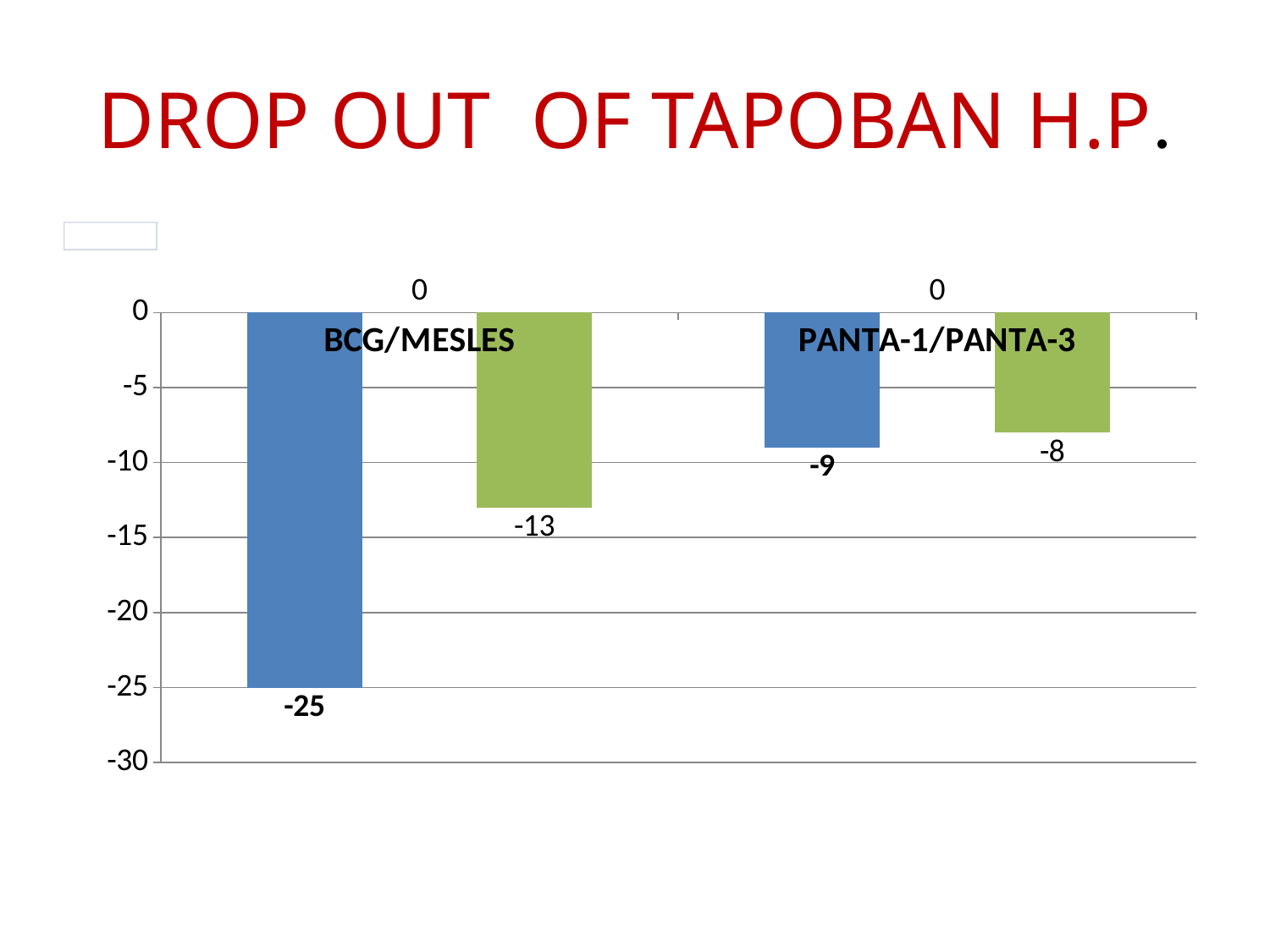
What kind of chart is shown on the slide? bar chart What is the difference between the green bar values for BCG/MESLES and PANTA-1/PANTA-3? 5 What is the difference between the blue bar values for BCG/MESLES and PANTA-1/PANTA-3? 16 What is the title of the slide containing the chart? DROP OUT OF TAPOBAN H.P. What is the value of the blue bar for BCG/MESLES? -25 What is the value of the green bar for BCG/MESLES? -13 Which category has the longer blue bar, BCG/MESLES or PANTA-1/PANTA-3? BCG/MESLES Which category has the lowest value among the green bars? BCG/MESLES Which category has the lowest value among the blue bars? BCG/MESLES How many categories are shown on the x axis of the chart? 2 What is the value of the green bar for PANTA-1/PANTA-3? -8 What is the value of the blue bar for PANTA-1/PANTA-3? -9